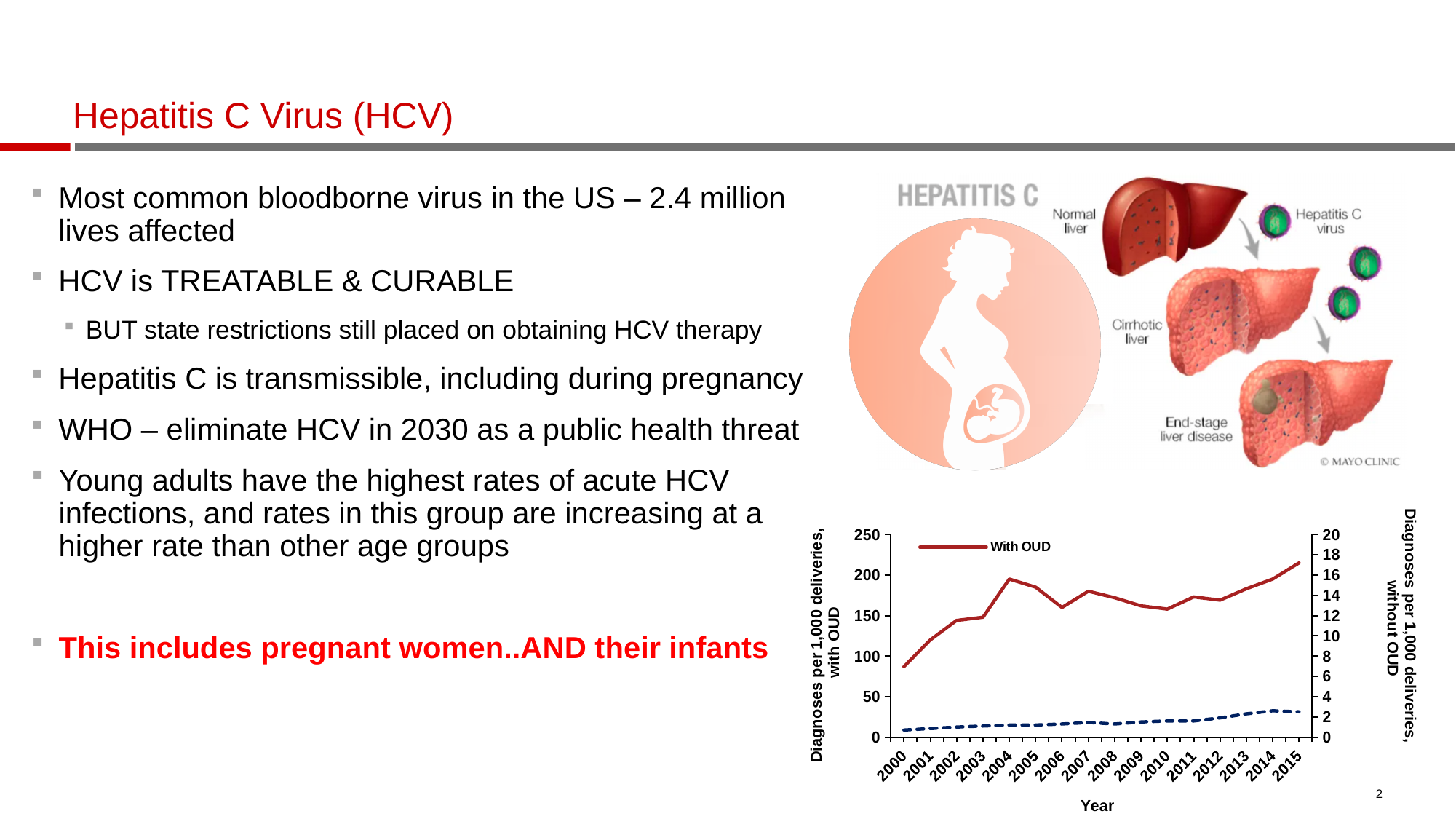
How many years are plotted along the x axis of the line chart? 16 Overall, does the With OUD line rise or fall from 2000 to 2015? rise Is the With OUD value for 2000 greater or less than 100? less Is the With OUD value for 2004 greater or less than 150? greater What is the last year shown on the x axis of the line chart? 2015 What is the first year shown on the x axis of the line chart? 2000 Which year has a higher With OUD value, 2004 or 2006? 2004 What is the title of the x axis of the line chart? Year In which year is the With OUD line at its highest value? 2015 In which year is the With OUD line at its lowest value? 2000 What kind of chart is shown at the bottom right of the slide? line chart Is the With OUD value for 2015 greater or less than 200? greater